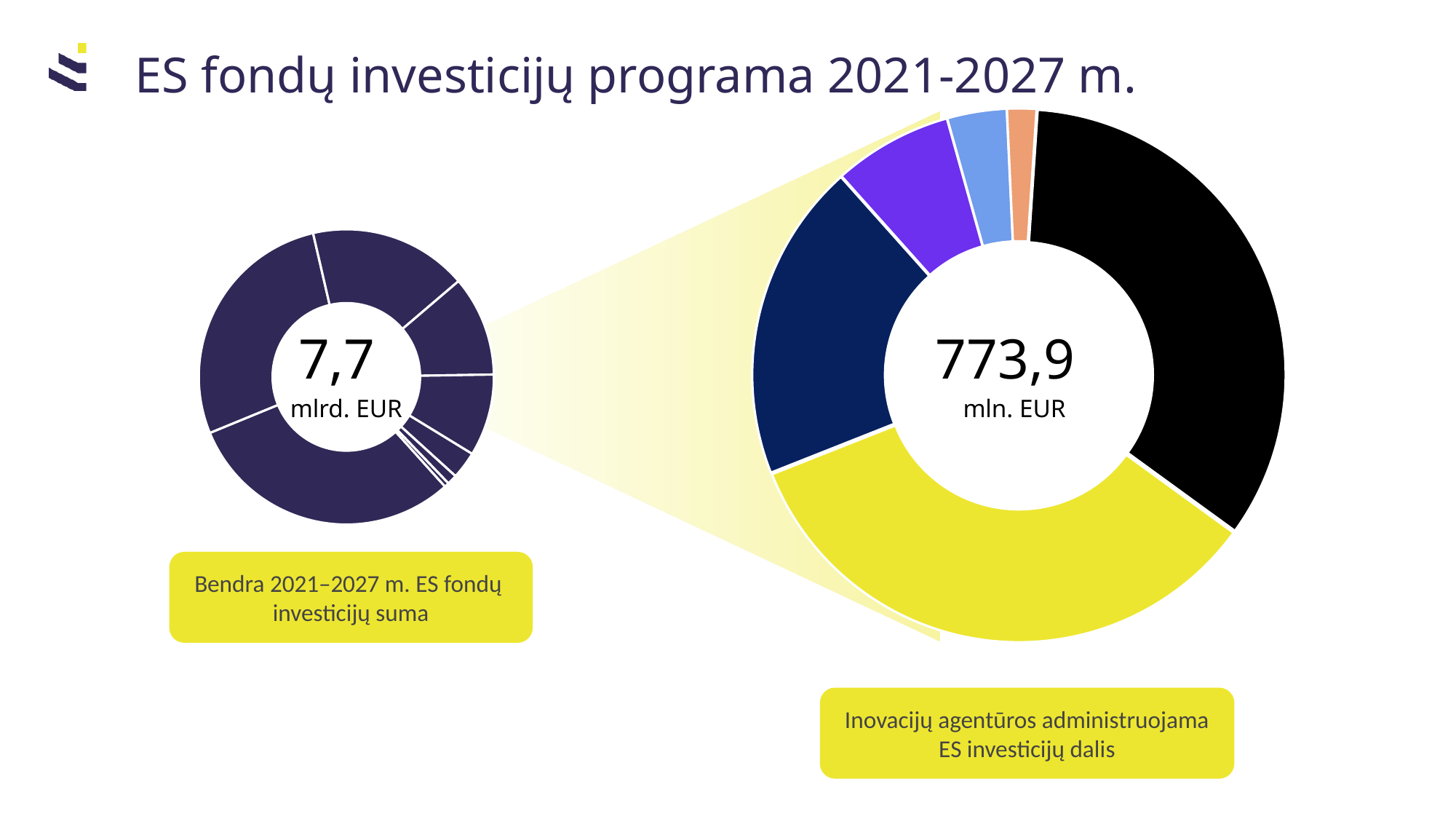
What does the caption under the right chart say? Inovacijų agentūros administruojama ES investicijų dalis What kind of chart is the chart on the right of the slide? Pie (donut) chart What value is shown in the centre of the left chart? 7,7 mlrd. EUR What is the title of the slide? ES fondų investicijų programa 2021-2027 m. In the right chart, which colour slice is the smallest? Orange What kind of chart is the chart on the left of the slide? Pie (donut) chart In the right chart, which is larger, the black slice or the dark navy slice? The black slice In the right chart, which is larger, the yellow slice or the purple slice? The yellow slice In the right chart, which is larger, the light blue slice or the orange slice? The light blue slice How many slices does the right chart have? 6 What value is shown in the centre of the right chart? 773,9 mln. EUR